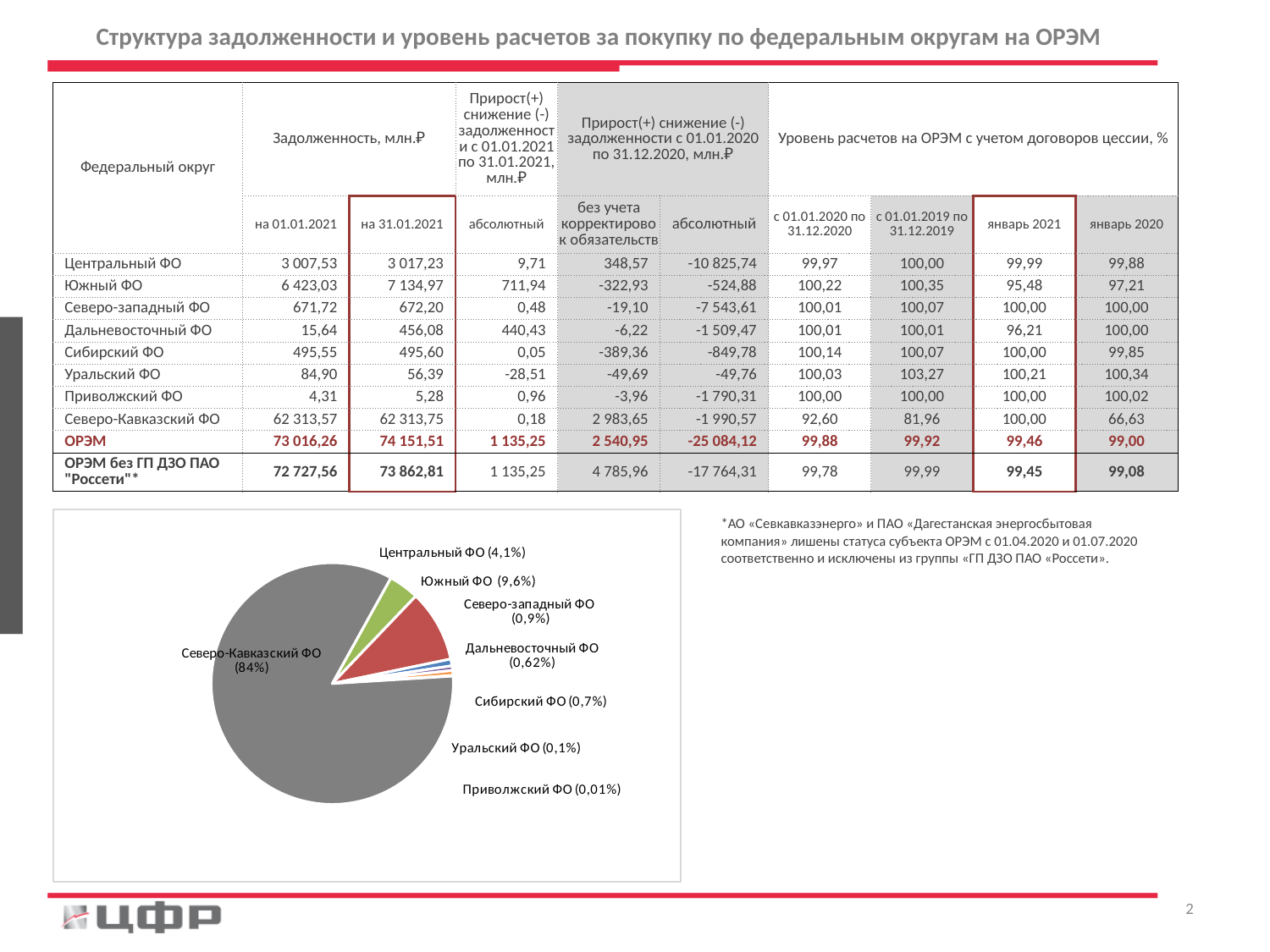
What share of the pie does Центральный ФО have? 4,1% What share of the pie does Приволжский ФО have? 0,01% Which slice of the pie chart is the largest? Северо-Кавказский ФО What is the difference in share between Сибирский ФО and Уральский ФО in the pie chart? 0,6% What share of the pie does Дальневосточный ФО have? 0,62% Which slice of the pie chart is the smallest? Приволжский ФО What kind of chart is shown on the slide? pie chart Which has the larger share in the pie chart, Южный ФО or Центральный ФО? Южный ФО How many slices does the pie chart have? 8